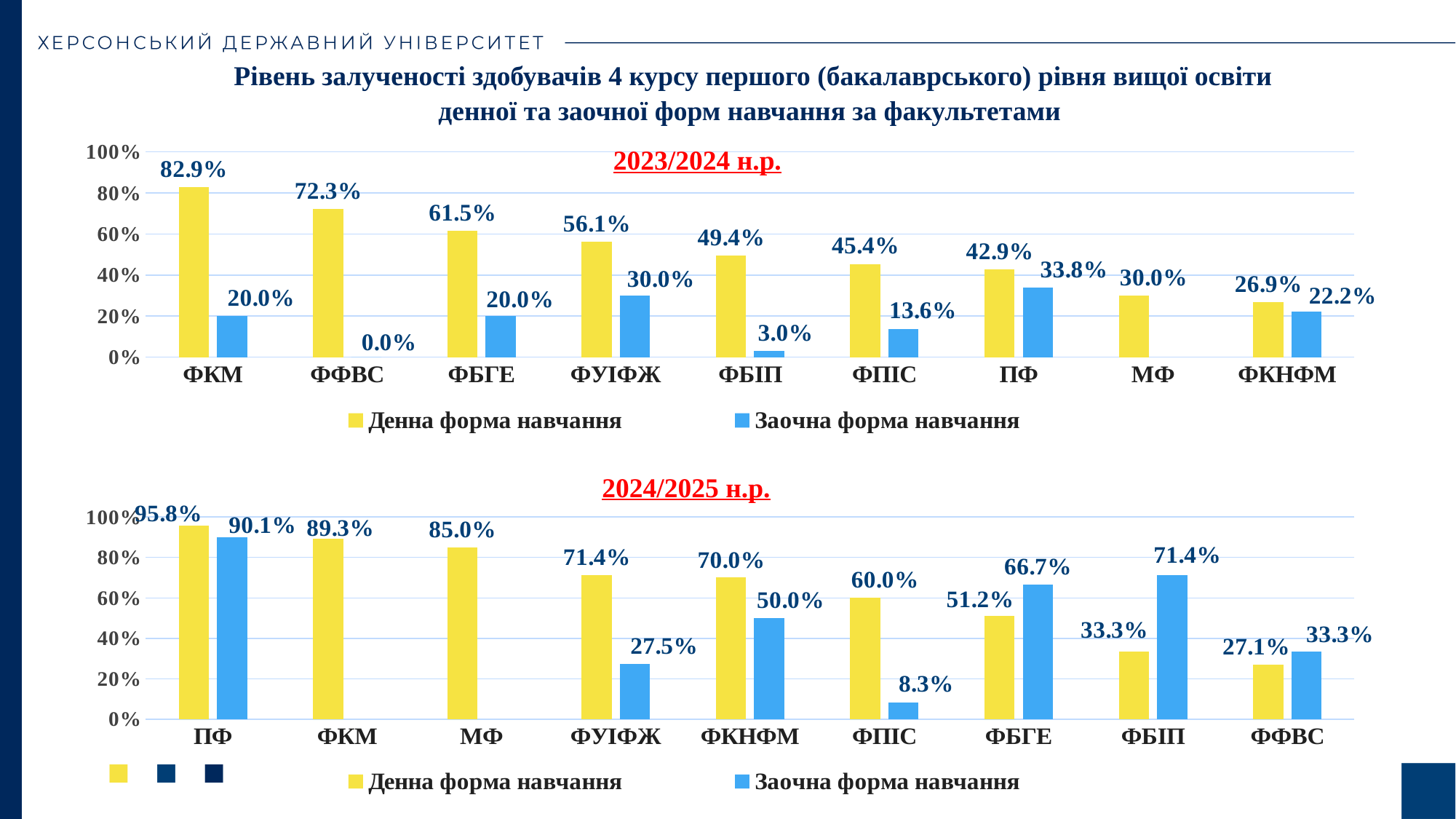
In the 2023/2024 н.р. chart, what is the value for Заочна форма навчання for ПФ? 33.8% In the 2024/2025 н.р. chart, which faculty has the highest Денна форма навчання value? ПФ What kind of chart is the 2024/2025 н.р. chart? Bar chart In the 2023/2024 н.р. chart, what is the value for Денна форма навчання for ФКМ? 82.9% In the 2024/2025 н.р. chart, what is the value for Заочна форма навчання for ФБІП? 71.4% In the 2024/2025 н.р. chart, which is larger for ФБГЕ: Денна форма навчання or Заочна форма навчання? Заочна форма навчання In the 2023/2024 н.р. chart, which faculty has the lowest Денна форма навчання value? ФКНФМ In the 2024/2025 н.р. chart, what is the difference between the Денна and Заочна values for ФПІС? 51.7% In the 2023/2024 н.р. chart, how many faculties are shown on the x axis? 9 In the 2023/2024 н.р. chart, what colour represents Заочна форма навчання? Blue In the 2024/2025 н.р. chart, how many series does the legend list? 2 In the 2023/2024 н.р. chart, what is the difference between the Денна and Заочна values for ФУІФЖ? 26.1%